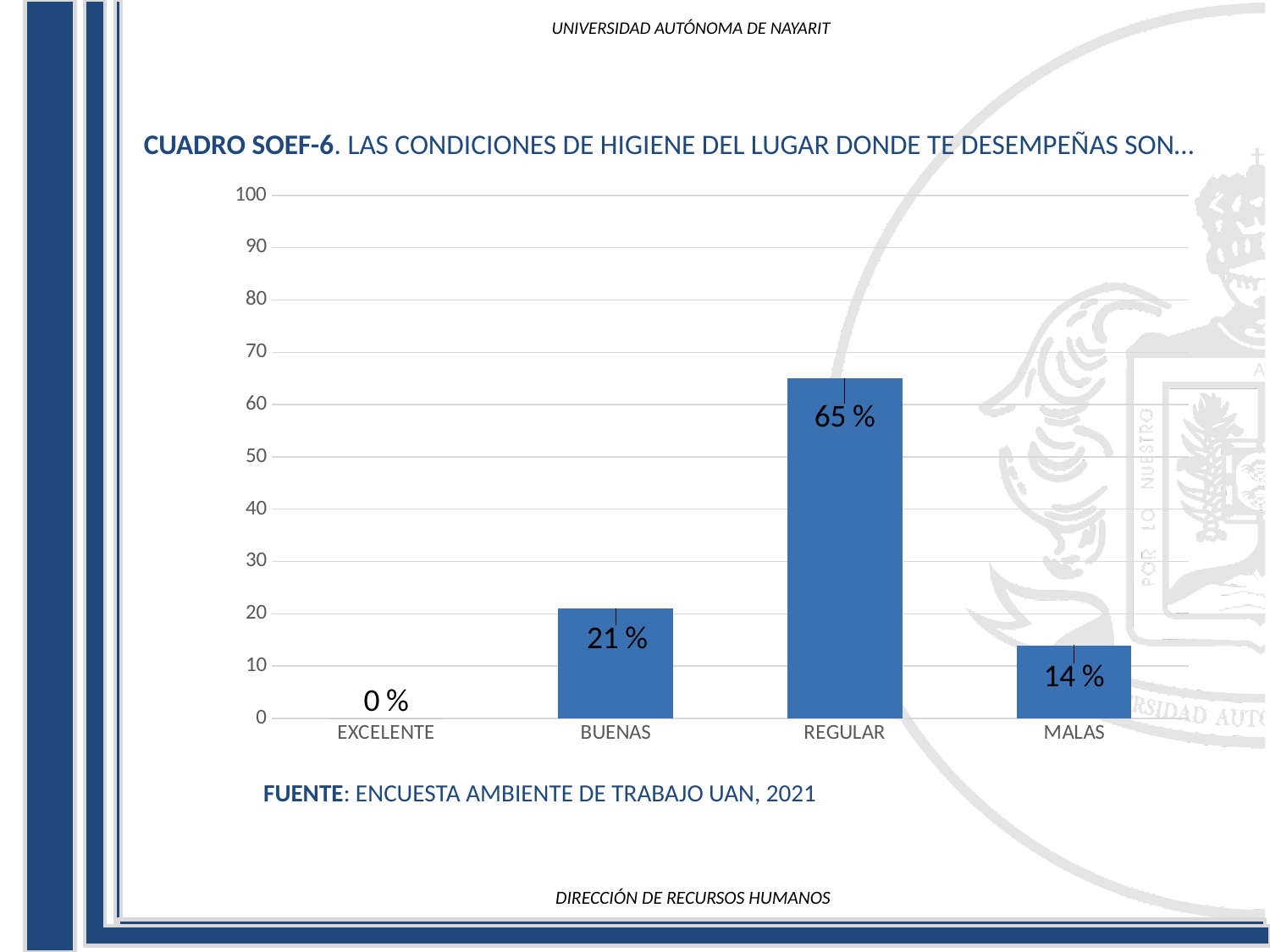
What is the value for BUENAS? 21 % What source is cited below the chart? ENCUESTA AMBIENTE DE TRABAJO UAN, 2021 What is the value for REGULAR? 65 % Which category has the lowest value? EXCELENTE Is the value for REGULAR greater or less than 50? greater What is the difference between the values for REGULAR and BUENAS? 44 % How many categories are shown on the x axis? 4 What is the value for MALAS? 14 % Which is larger, the value for BUENAS or the value for MALAS? BUENAS What kind of chart is shown on the slide? bar chart What is the value for EXCELENTE? 0 % Which category has the highest value? REGULAR